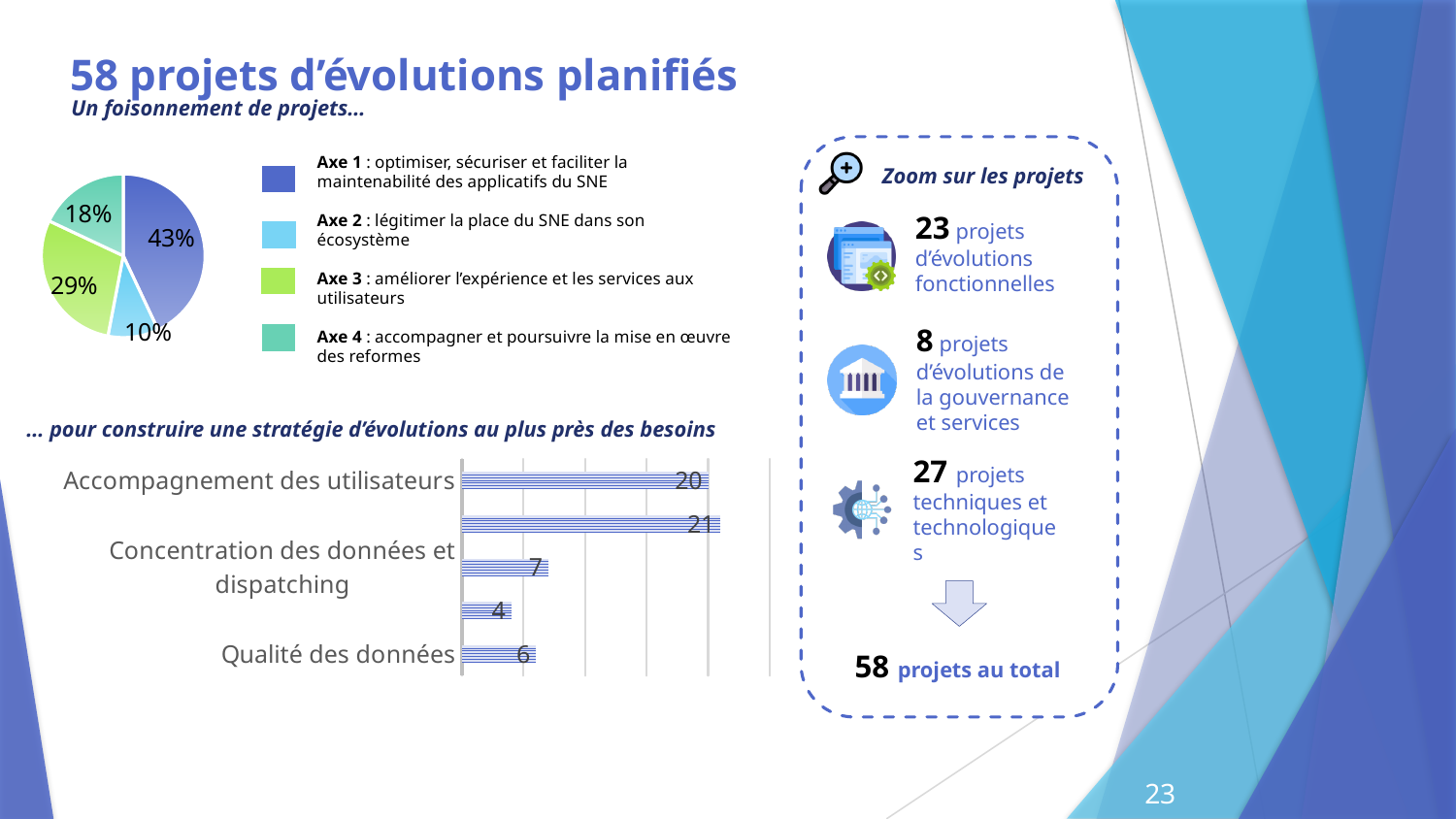
In the pie chart, how many slices are there? 4 In the pie chart, what share is shown for Axe 3? 29% In the pie chart, what share is shown for Axe 2? 10% In the bar chart, what is the value for Qualité des données? 6 What kind of chart is the chart at the top left of the slide? Pie chart In the bar chart, which is larger, Accompagnement des utilisateurs or Qualité des données? Accompagnement des utilisateurs In the pie chart, which axe has the smallest share? Axe 2 In the pie chart, what share is shown for Axe 1? 43% In the pie chart, what is the difference between the shares of Axe 1 and Axe 3? 14% In the bar chart, what is the value for Accompagnement des utilisateurs? 20 In the pie chart, which axe has the largest share? Axe 1 What kind of chart is the chart at the bottom left of the slide? Bar chart